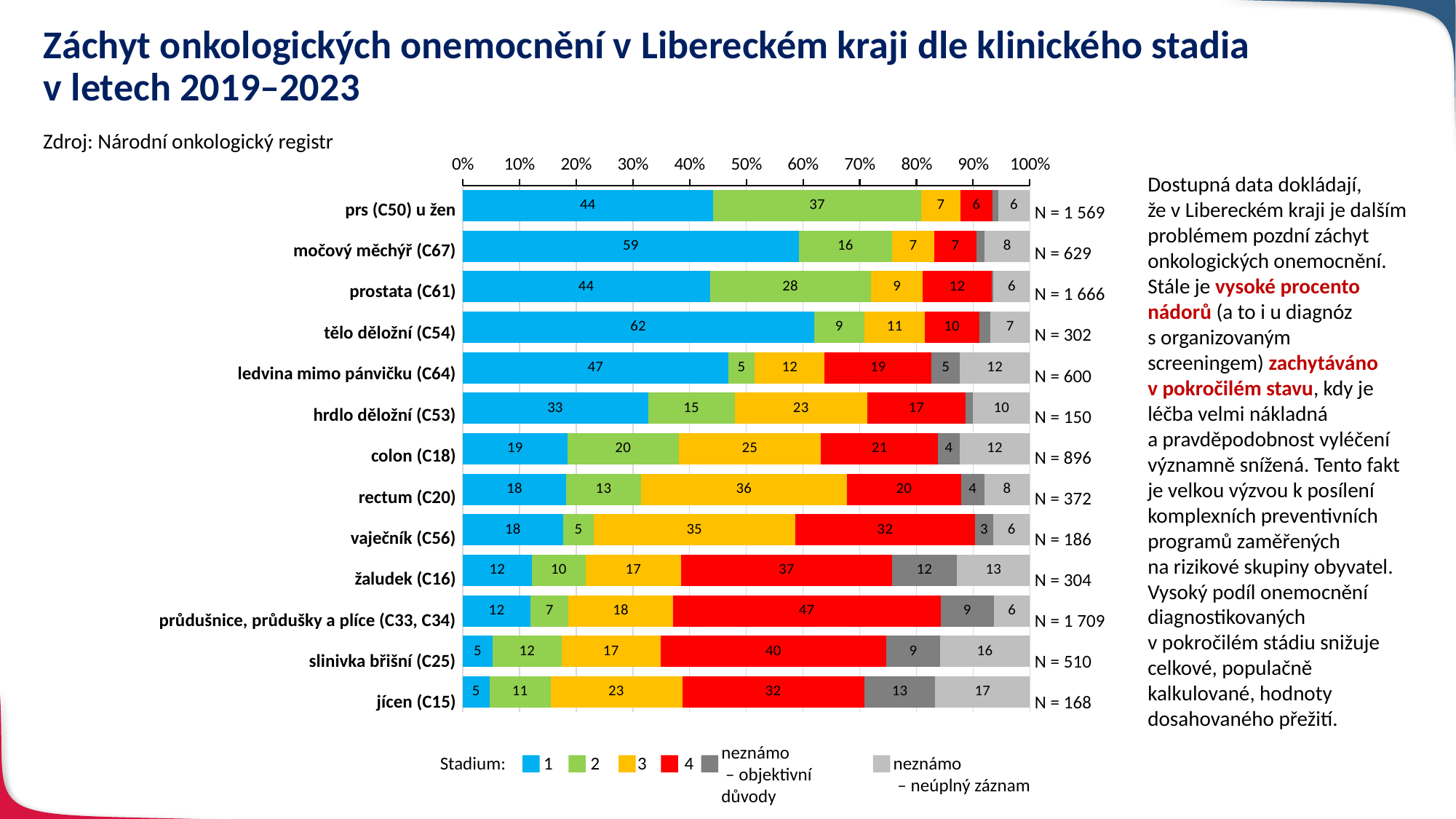
Which diagnosis has the highest value for stage 1? tělo děložní (C54) What is the difference between the stage 4 value for vaječník (C56) and the stage 4 value for colon (C18)? 11 What is the value for stage 1 for tělo děložní (C54)? 62 Which has the larger stage 1 value, prostata (C61) or močový měchýř (C67)? močový měchýř (C67) Which diagnosis has the lowest value for stage 4? prs (C50) u žen What is the value for stage 4 for průdušnice, průdušky a plíce (C33, C34)? 47 Which diagnosis has the highest value for stage 4? průdušnice, průdušky a plíce (C33, C34) How many diagnoses are shown in the chart? 13 How many series does the legend list? 6 What is the N value shown for prs (C50) u žen? N = 1 569 What is the value for stage 3 for rectum (C20)? 36 What kind of chart is shown on the slide? stacked bar chart